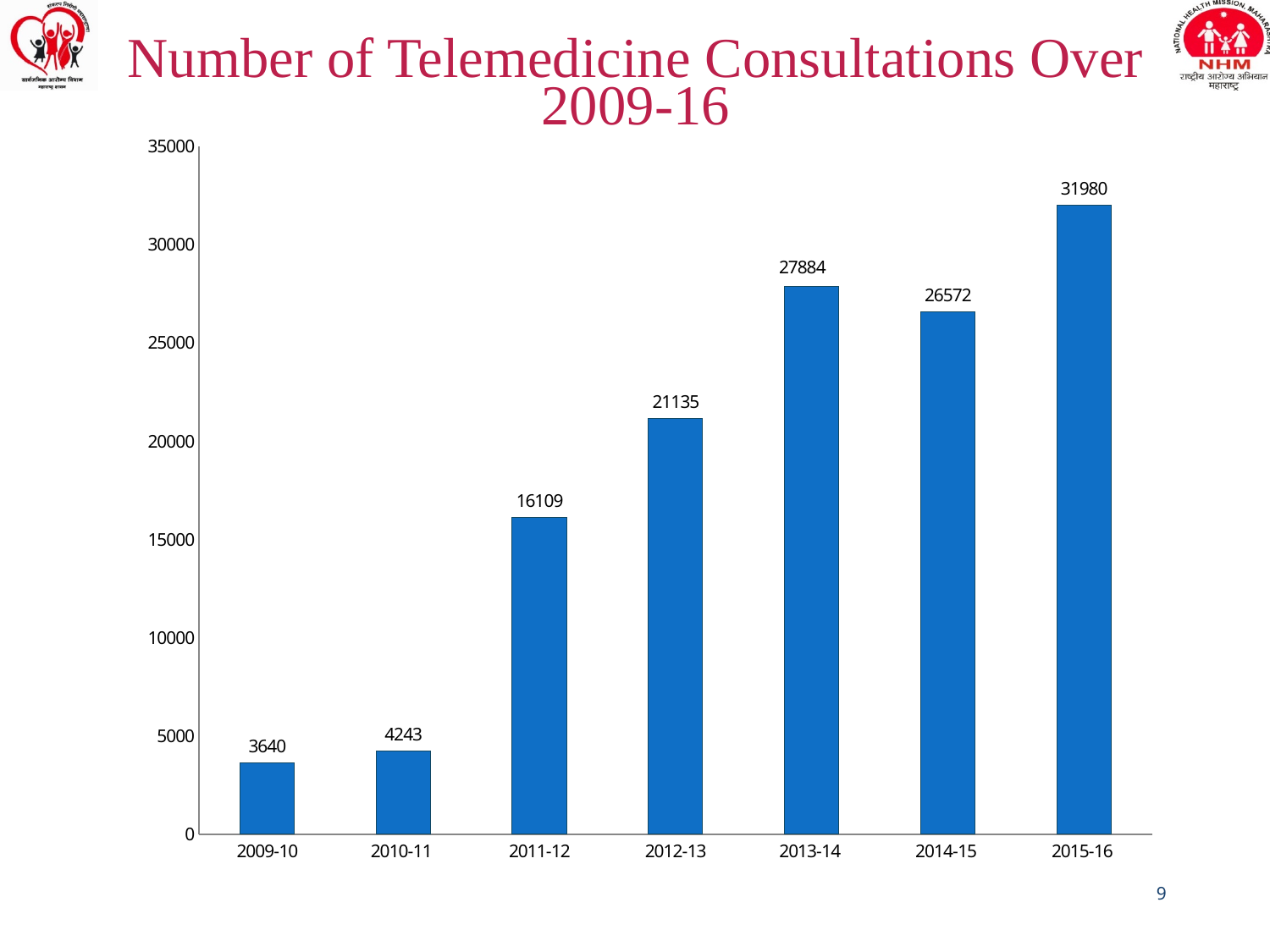
What is the number of telemedicine consultations for 2011-12? 16109 What is the difference in consultations between 2010-11 and 2009-10? 603 Which year had more consultations, 2013-14 or 2014-15? 2013-14 How many years are shown on the chart? 7 Is the value for 2012-13 greater or less than 20000? greater What is the number of telemedicine consultations for 2014-15? 26572 Do the consultations rise or fall from 2009-10 to 2013-14? Rise What is the difference in consultations between 2015-16 and 2014-15? 5408 Which year has the lowest number of telemedicine consultations? 2009-10 What kind of chart is shown on the slide? Bar chart What is the title of the chart? Number of Telemedicine Consultations Over 2009-16 Which year has the highest number of telemedicine consultations? 2015-16